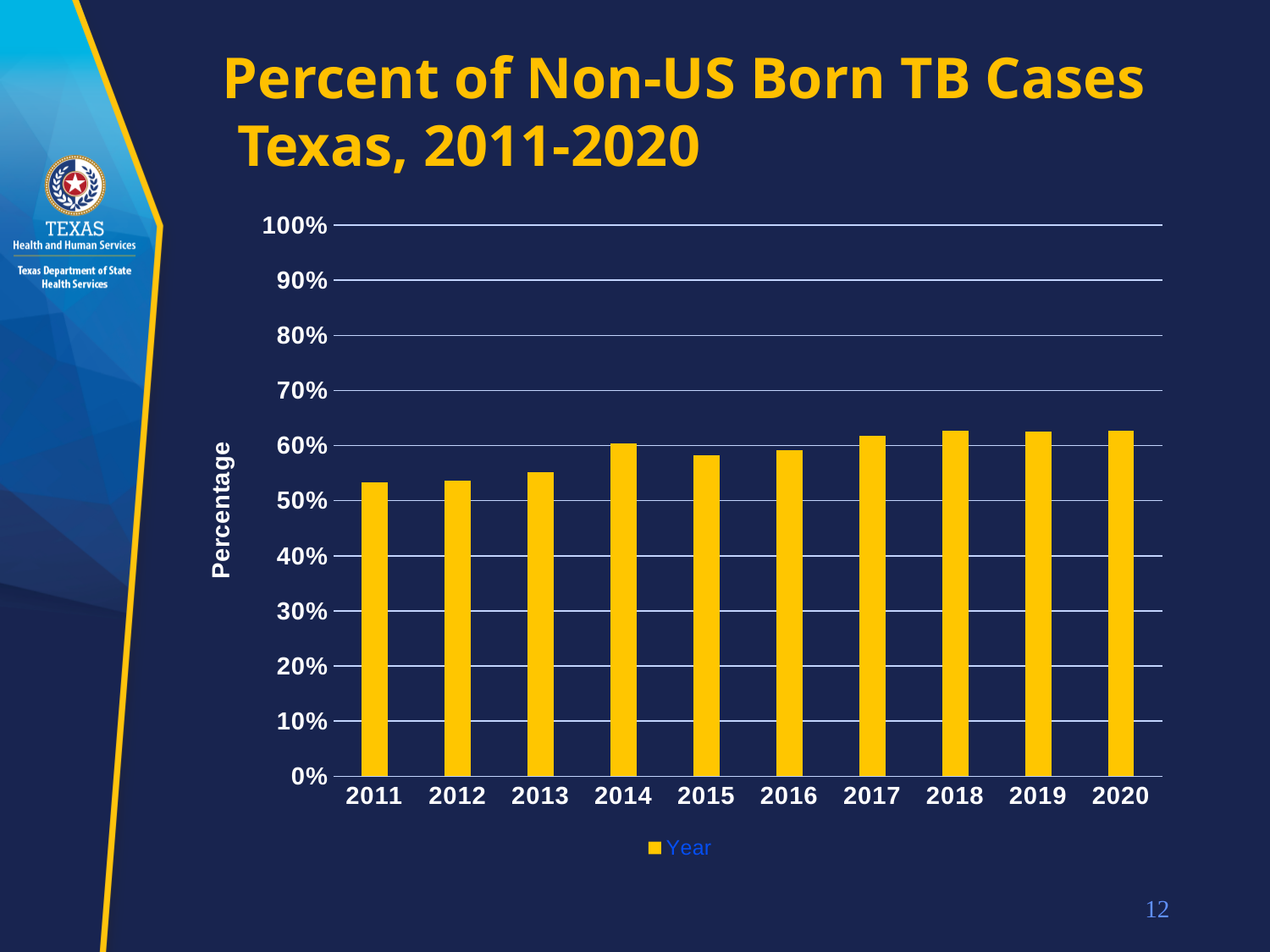
Is the value for 2018 greater or less than 60%? greater What is the title of the chart? Percent of Non-US Born TB Cases Texas, 2011-2020 How many years are shown on the x axis of the chart? 10 Which is larger, the value for 2011 or the value for 2018? 2018 What is the label on the vertical axis? Percentage Is the value for 2013 greater or less than 50%? greater Which is larger, the value for 2014 or the value for 2012? 2014 Is the value for 2015 greater or less than 60%? less What type of chart is shown on the slide? bar chart Do the values generally rise or fall from 2011 to 2020? rise How many series does the legend list? 1